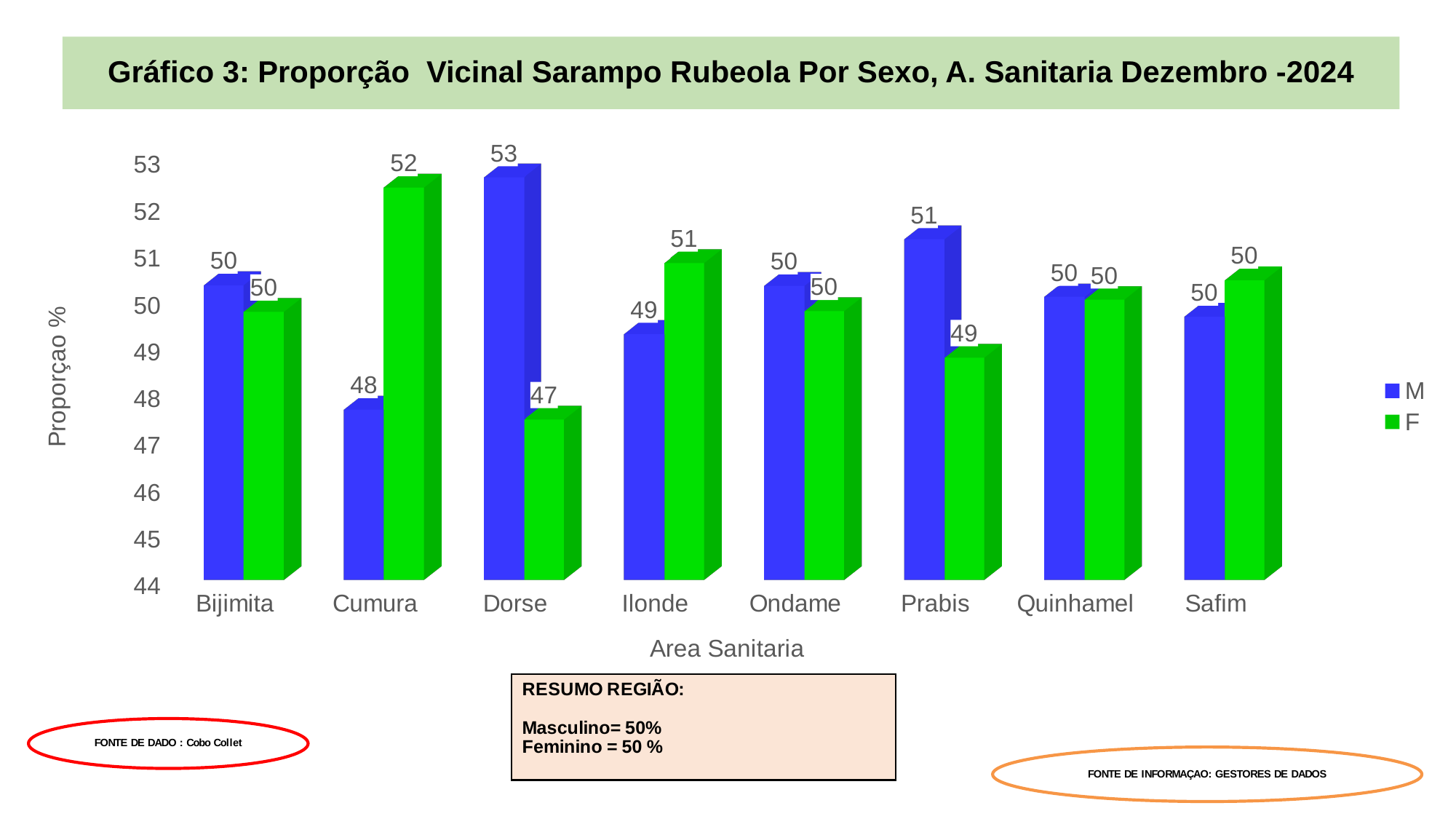
What is the value for F in Cumura? 52 What kind of chart is shown on the slide? Bar chart Which area sanitaria has the lowest value for F? Dorse What is the difference between the M and F values in Dorse? 6 How many series does the legend list? 2 What is the value for F in Prabis? 49 Which area sanitaria has the highest value for M? Dorse How many areas sanitarias are shown on the x axis? 8 What is the value for M in Ilonde? 49 In Cumura, which is larger, the value for M or the value for F? F What is the value for M in Dorse? 53 Which area sanitaria has the lowest value for M? Cumura